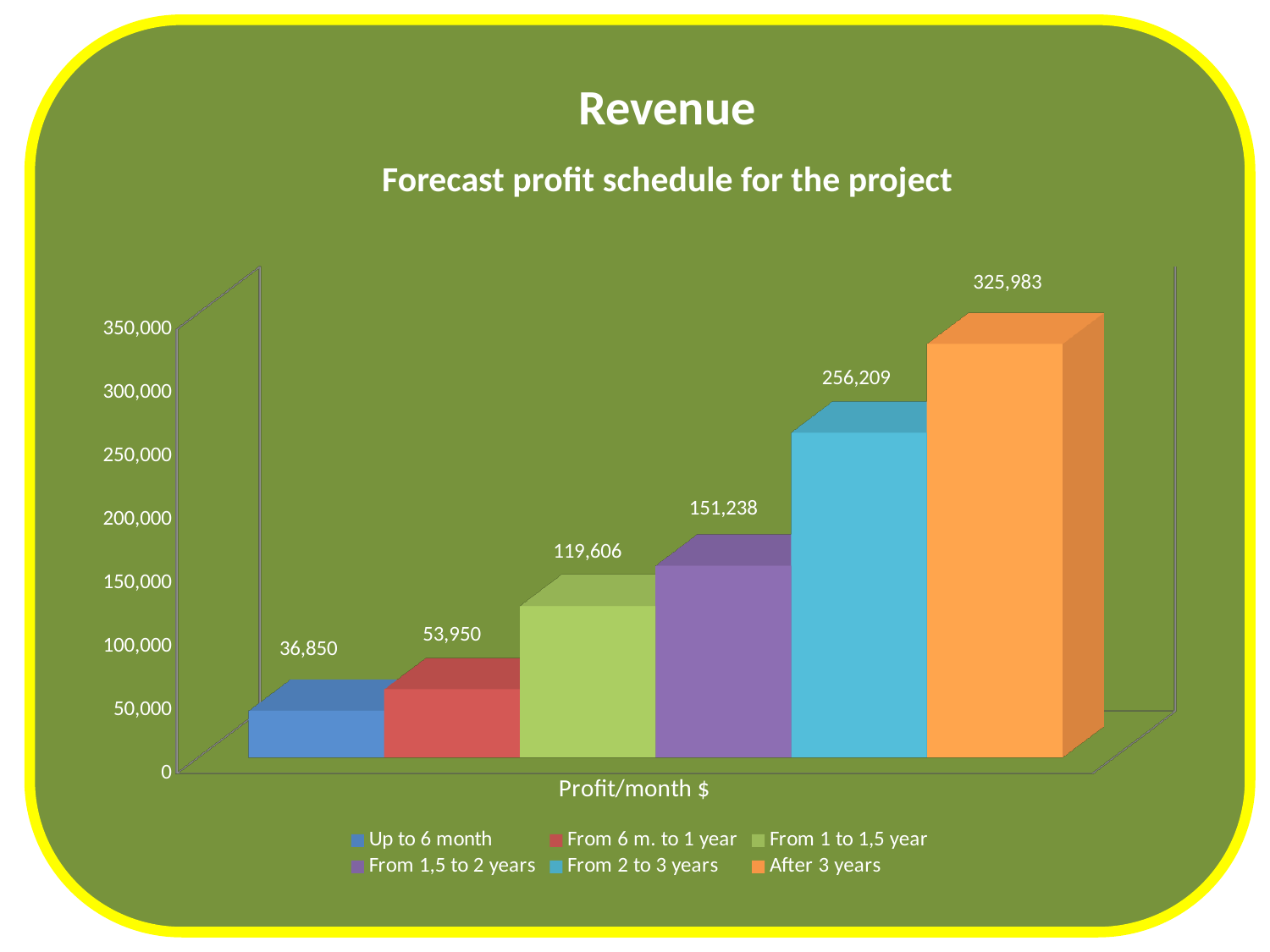
What is the value for 'From 2 to 3 years'? 256,209 Which is larger, the value for 'From 1,5 to 2 years' or 'From 1 to 1,5 year'? From 1,5 to 2 years Do the values rise or fall from left to right across the bars? Rise What is the chart's title? Forecast profit schedule for the project What is the value for 'From 1 to 1,5 year'? 119,606 Which series has the highest value? After 3 years How many series does the legend list? 6 What is the difference between the values for 'From 6 m. to 1 year' and 'Up to 6 month'? 17,100 What is the difference between the values for 'After 3 years' and 'From 2 to 3 years'? 69,774 Which series has the lowest value? Up to 6 month What kind of chart is shown? Bar chart What is the value for 'Up to 6 month'? 36,850